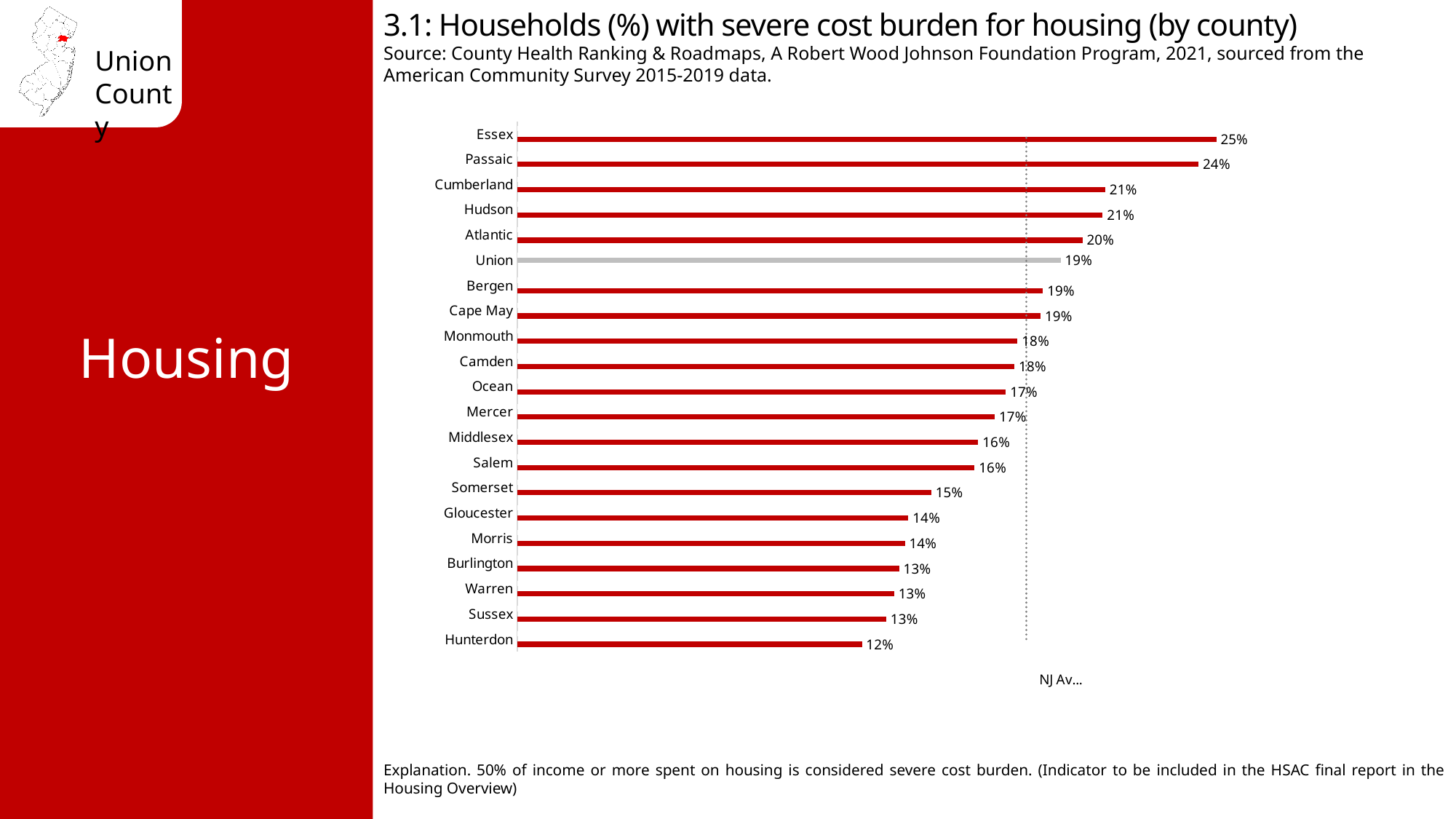
What type of chart is used on this slide? Bar chart What is the value shown for Hunterdon? 12% What is the difference between the values for Passaic and Union? 5% Which has a higher value, Atlantic or Middlesex? Atlantic Which county's bar is shown in grey instead of red? Union How many counties are shown in the chart? 21 What percentage of households in Union County have a severe cost burden for housing? 19% Which county has the highest percentage of households with severe housing cost burden? Essex What is the value shown for Essex? 25% What is the value shown for Somerset? 15% What is the difference between the values for Essex and Hunterdon? 13% Which county has the lowest percentage of households with severe housing cost burden? Hunterdon